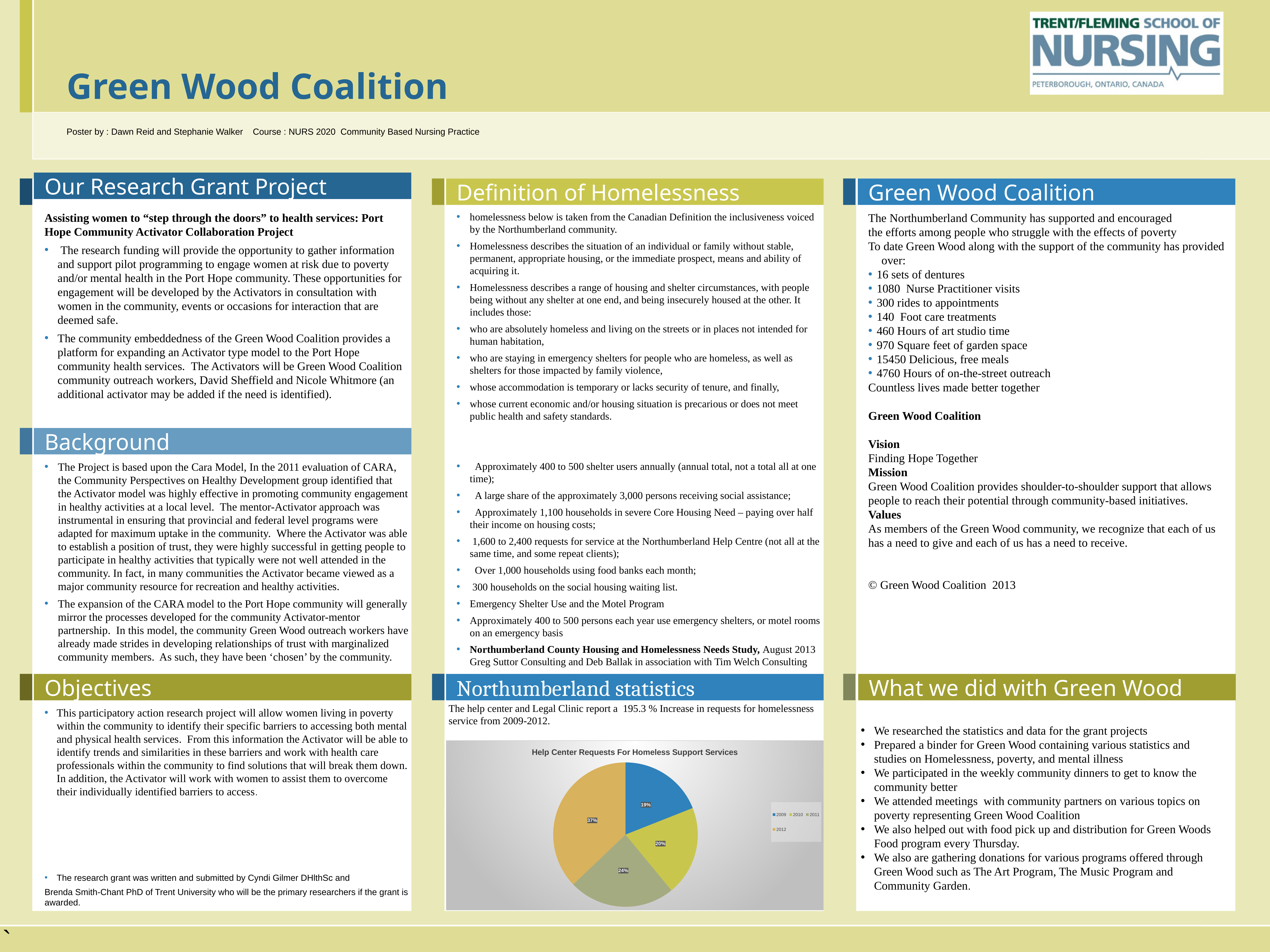
What kind of chart is shown under the Northumberland statistics heading? pie chart Which year has the largest slice in the pie chart? 2012 What share of the pie chart does 2010 represent? 20% What share of the pie chart does 2011 represent? 24% In the pie chart, what is the difference in percentage points between the 2012 slice and the 2009 slice? 18 Which year has the smallest slice in the pie chart? 2009 What share of the pie chart does 2012 represent? 37% How many years does the legend of the pie chart list? 4 What is the title of the pie chart on the slide? Help Center Requests For Homeless Support Services Which year is shown in orange in the pie chart? 2012 In the pie chart, which slice is larger, 2011 or 2010? 2011